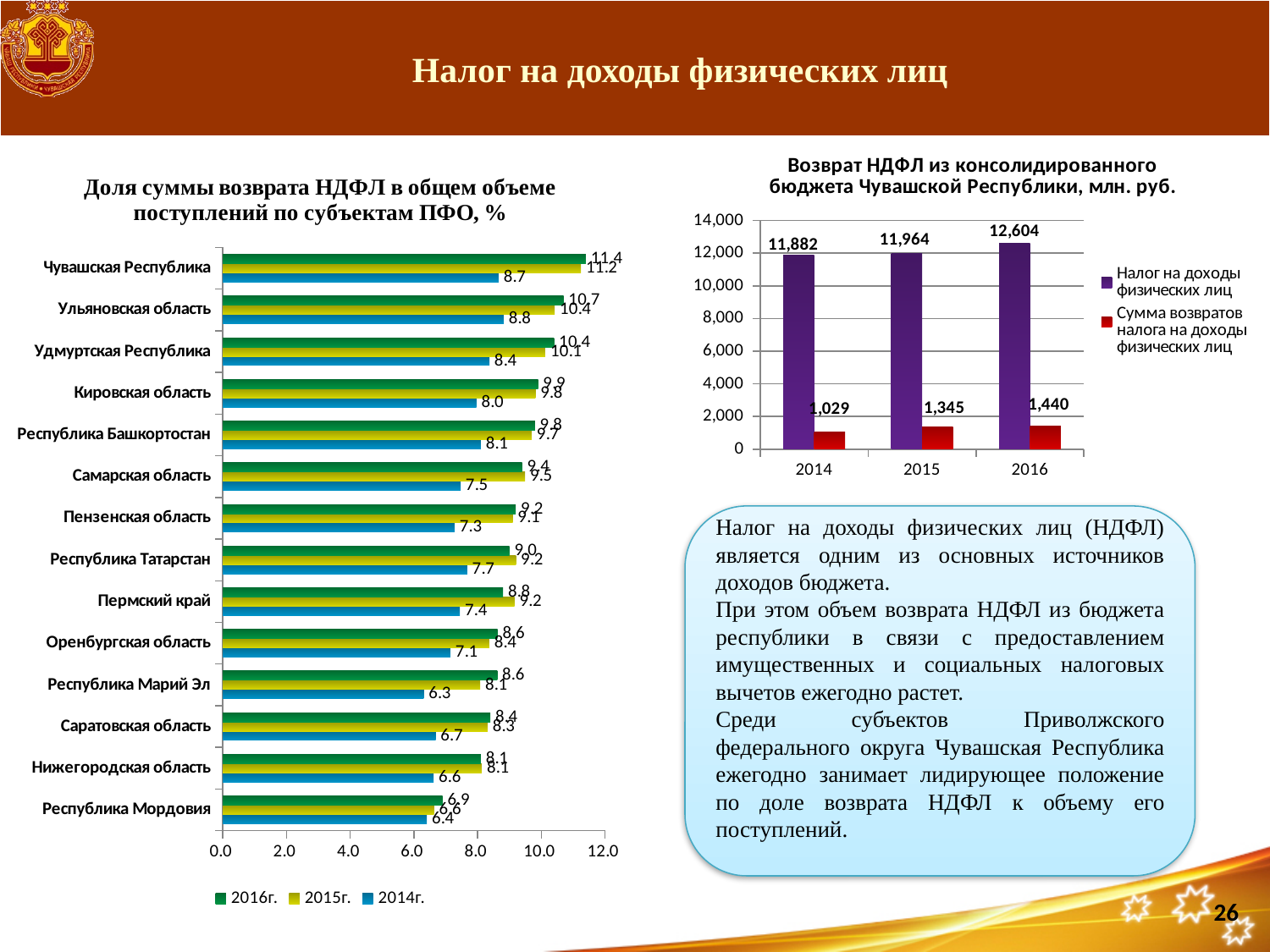
In the chart 'Доля суммы возврата НДФЛ в общем объеме поступлений по субъектам ПФО, %', what is the value for Чувашская Республика in 2016г.? 11.4 In the chart 'Доля суммы возврата НДФЛ в общем объеме поступлений по субъектам ПФО, %', what is the value for Республика Мордовия in 2014г.? 6.4 How many series does the legend of the chart 'Возврат НДФЛ из консолидированного бюджета Чувашской Республики, млн. руб.' list? 2 In the chart 'Возврат НДФЛ из консолидированного бюджета Чувашской Республики, млн. руб.', does the value of 'Налог на доходы физических лиц' rise or fall from 2014 to 2016? rise In the chart 'Доля суммы возврата НДФЛ в общем объеме поступлений по субъектам ПФО, %', which region has the lowest value for 2014г.? Республика Марий Эл In the chart 'Возврат НДФЛ из консолидированного бюджета Чувашской Республики, млн. руб.', what is the value of 'Налог на доходы физических лиц' for 2016? 12,604 What kind of chart is 'Доля суммы возврата НДФЛ в общем объеме поступлений по субъектам ПФО, %'? bar chart In the chart 'Доля суммы возврата НДФЛ в общем объеме поступлений по субъектам ПФО, %', what is the difference between the 2016г. and 2014г. values for Ульяновская область? 1.9 In the chart 'Доля суммы возврата НДФЛ в общем объеме поступлений по субъектам ПФО, %', which region has the highest value for 2016г.? Чувашская Республика In the chart 'Возврат НДФЛ из консолидированного бюджета Чувашской Республики, млн. руб.', what is the value of 'Сумма возвратов налога на доходы физических лиц' for 2014? 1,029 How many regions are shown in the chart 'Доля суммы возврата НДФЛ в общем объеме поступлений по субъектам ПФО, %'? 14 In the chart 'Возврат НДФЛ из консолидированного бюджета Чувашской Республики, млн. руб.', by how much did 'Сумма возвратов налога на доходы физических лиц' increase from 2015 to 2016? 95